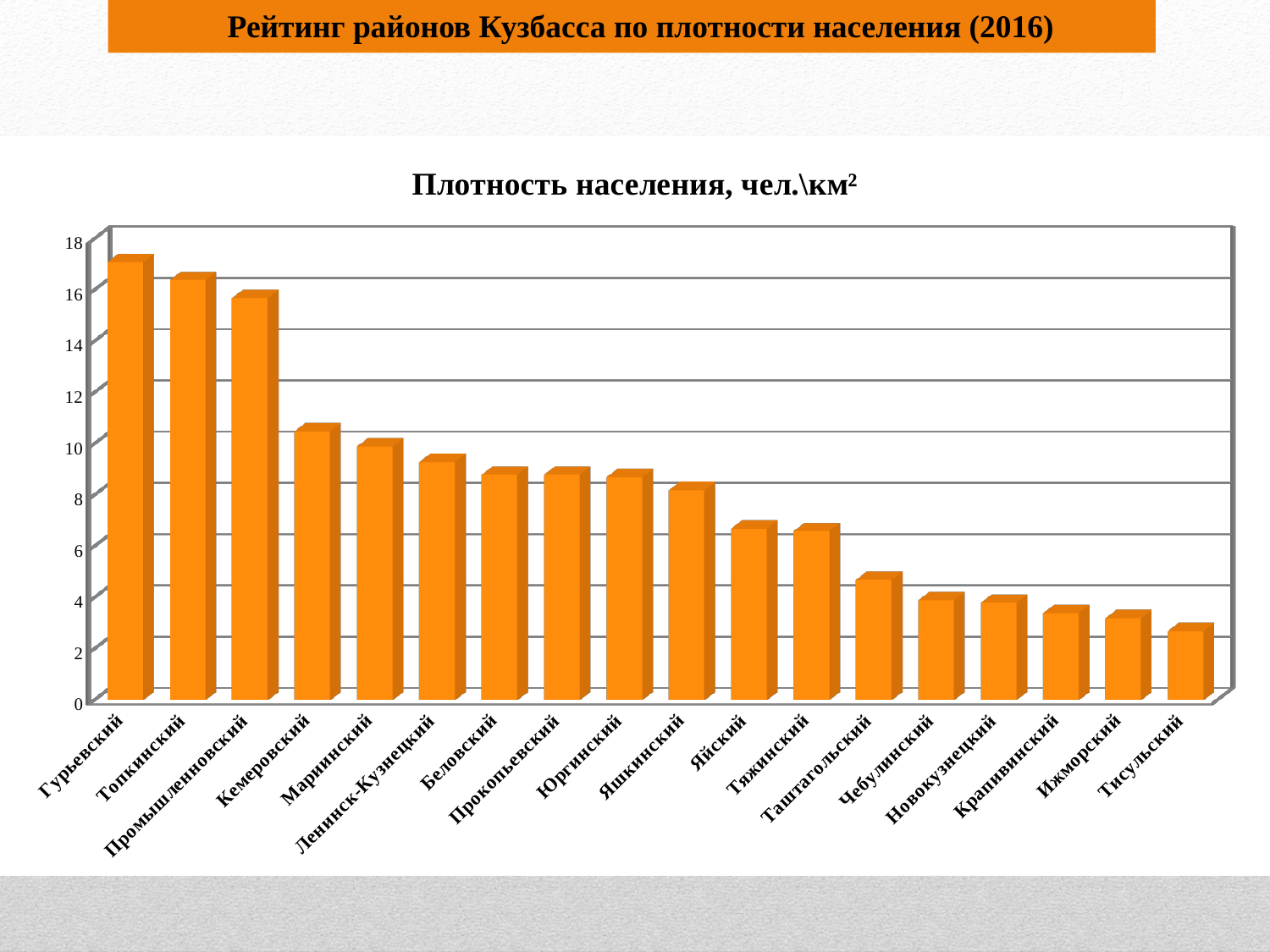
How many districts (categories) are plotted on the chart? 18 Is the value for Гурьевский greater or less than 16? greater What kind of chart is shown on the slide? bar chart Which has a higher population density, Кемеровский or Яйский? Кемеровский Is the value for Яшкинский greater or less than 10? less Is the value for Промышленновский greater or less than 14? greater Which district has the lowest population density on the chart? Тисульский What is the title of the chart? Плотность населения, чел.\км² Do the values rise or fall from left to right along the x axis? fall Which district has the highest population density on the chart? Гурьевский